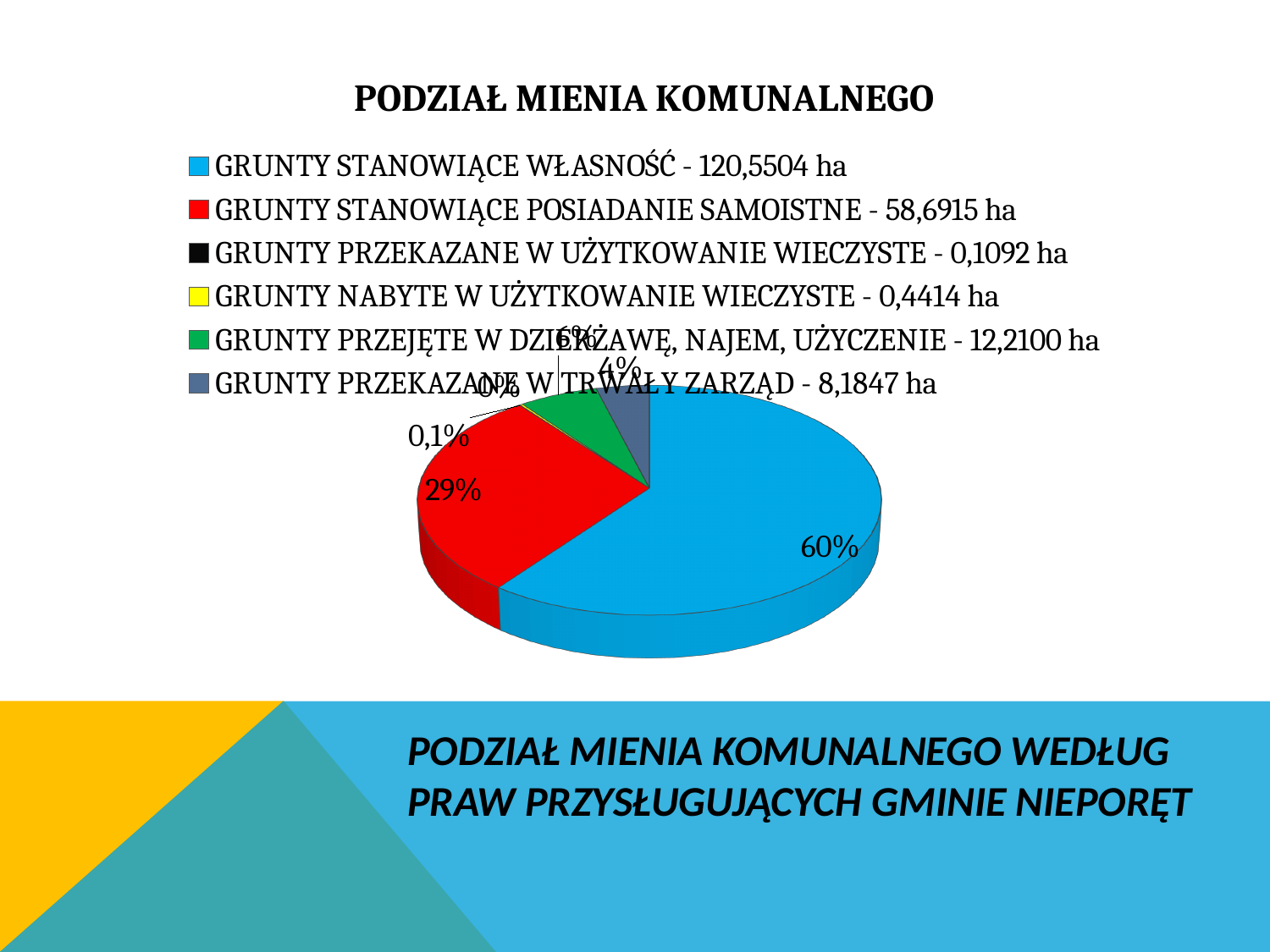
What share of the pie does GRUNTY STANOWIĄCE WŁASNOŚĆ represent? 60% What kind of chart is shown on the slide? pie chart Which category has the smallest area according to the legend? GRUNTY PRZEKAZANE W UŻYTKOWANIE WIECZYSTE What is the title of the pie chart? PODZIAŁ MIENIA KOMUNALNEGO What area in ha is given in the legend for GRUNTY PRZEJĘTE W DZIERŻAWĘ, NAJEM, UŻYCZENIE? 12,2100 ha Which is larger: the area of GRUNTY NABYTE W UŻYTKOWANIE WIECZYSTE or GRUNTY PRZEKAZANE W TRWAŁY ZARZĄD? GRUNTY PRZEKAZANE W TRWAŁY ZARZĄD How many categories does the legend of the pie chart list? 6 Which category has the largest slice of the pie? GRUNTY STANOWIĄCE WŁASNOŚĆ What area in ha is given in the legend for GRUNTY STANOWIĄCE WŁASNOŚĆ? 120,5504 ha What share of the pie does GRUNTY STANOWIĄCE POSIADANIE SAMOISTNE represent? 29% What area in ha is given in the legend for GRUNTY PRZEKAZANE W TRWAŁY ZARZĄD? 8,1847 ha